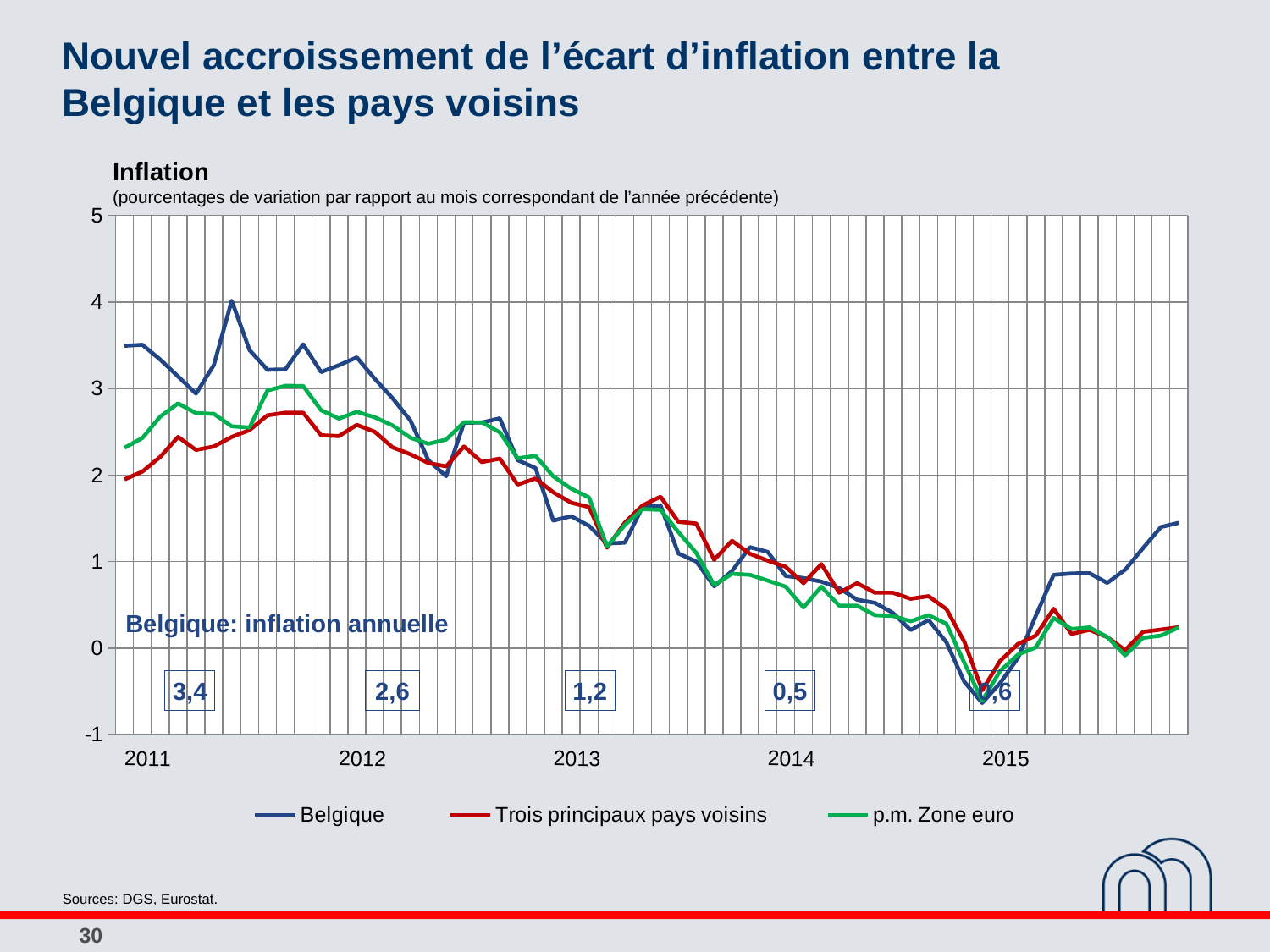
What is the difference between Belgium's annual inflation in 2011 and in 2012? 0,8 Is the value for Belgique at the last point of 2015 greater or less than 1? greater What is the annual inflation for Belgium shown for 2012? 2,6 Do the inflation values generally rise or fall from 2011 to early 2015? fall Is the value for Belgique at the start of 2011 greater or less than 3? greater How many series does the legend list? 3 At the start of 2011, which is higher: Belgique or Trois principaux pays voisins? Belgique What is the annual inflation for Belgium shown for 2013? 1,2 What is the annual inflation for Belgium shown for 2014? 0,5 What is the annual inflation for Belgium shown for 2011? 3,4 Among the annual inflation labels for Belgium for 2011 to 2014, which year has the highest value? 2011 What kind of chart is shown on the slide? line chart